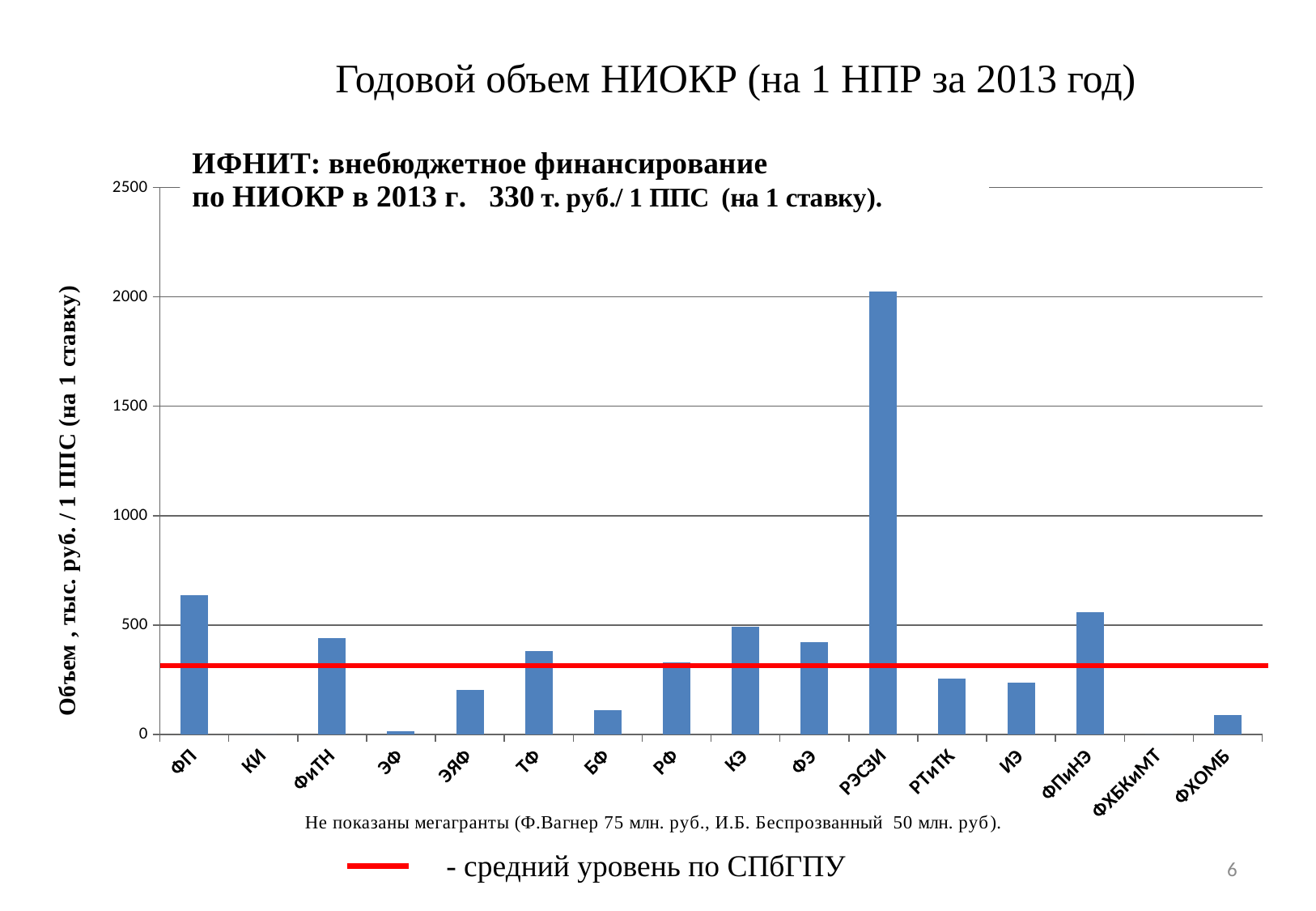
Is the value for ЭЯФ greater or less than 500? less How many categories are shown on the x axis? 16 Which is larger, the value for КЭ or the value for ЭЯФ? КЭ Is the value for БФ greater or less than 500? less What does the red horizontal line represent, according to the legend? средний уровень по СПбГПУ What kind of chart is shown on the slide? bar chart Is the value for ФПиНЭ greater or less than 500? greater What is the label of the y axis? Объем , тыс. руб. / 1 ППС (на 1 ставку) Which category has the highest bar? РЭСЗИ Which is larger, the value for ФП or the value for ФиТН? ФП